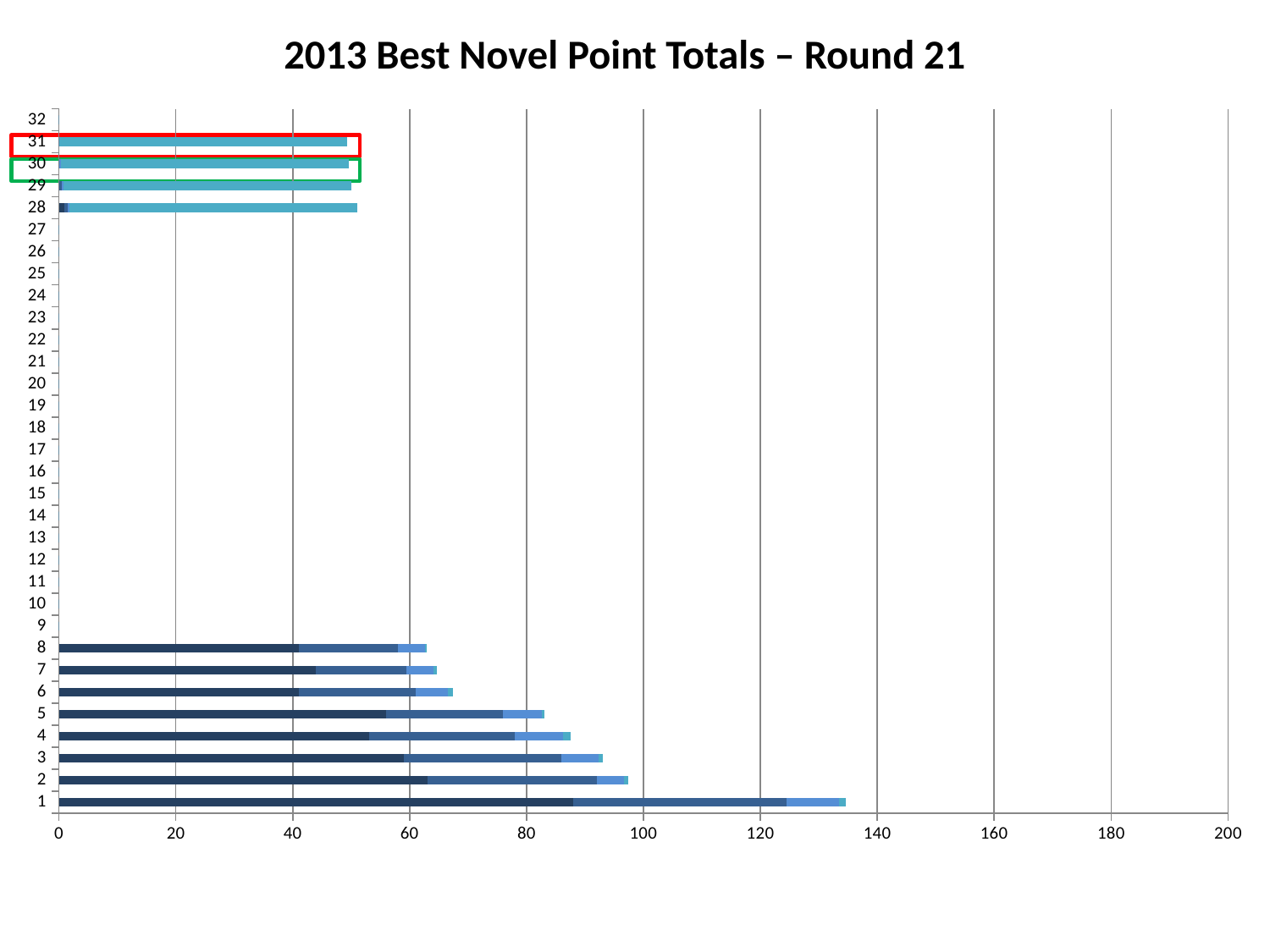
Is the total value for category 2 greater or less than 100? less Is the total value for category 31 greater or less than 60? less Is the total value for category 8 greater or less than 80? less What is the title of the chart? 2013 Best Novel Point Totals – Round 21 How many category labels are shown on the vertical axis? 32 Which category has the longest bar in the chart? 1 What kind of chart is shown on the slide? bar chart Which has the larger total, category 1 or category 2? 1 Which category is outlined with a red rectangle on the chart? 31